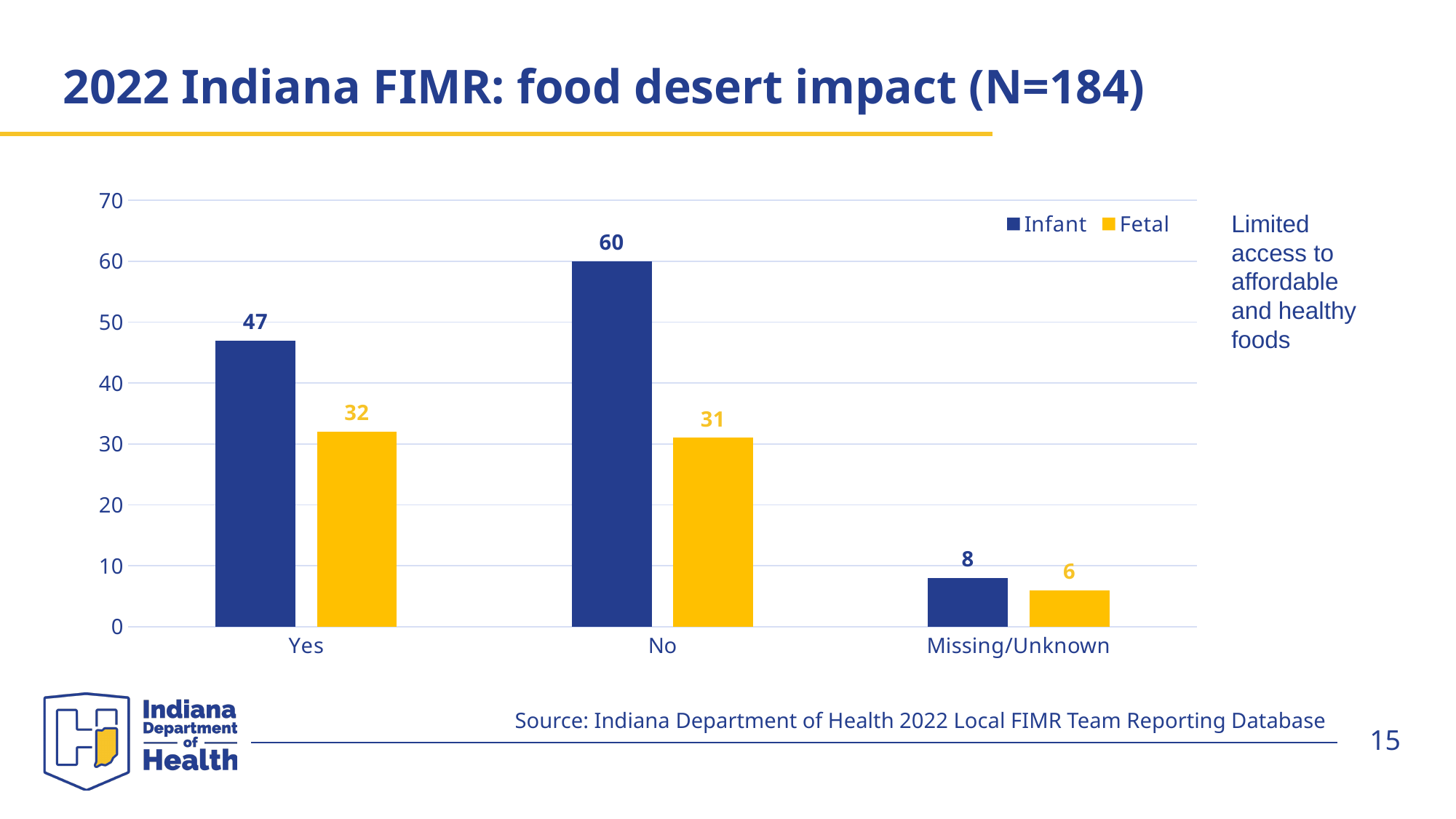
What is the Fetal value for the No category? 31 Which is larger, the Infant value for Yes or the Infant value for No? No What is the Infant value for the Yes category? 47 Which category has the lowest Fetal value? Missing/Unknown What kind of chart is shown on the slide? Bar chart How many series does the legend list? 2 How many categories are shown on the x axis? 3 What is the Fetal value for the Missing/Unknown category? 6 Which category has the highest Infant value? No What colour represents the Fetal series? Yellow Is the Fetal value for Yes greater or less than 30? greater What is the difference between the Infant and Fetal values for the No category? 29